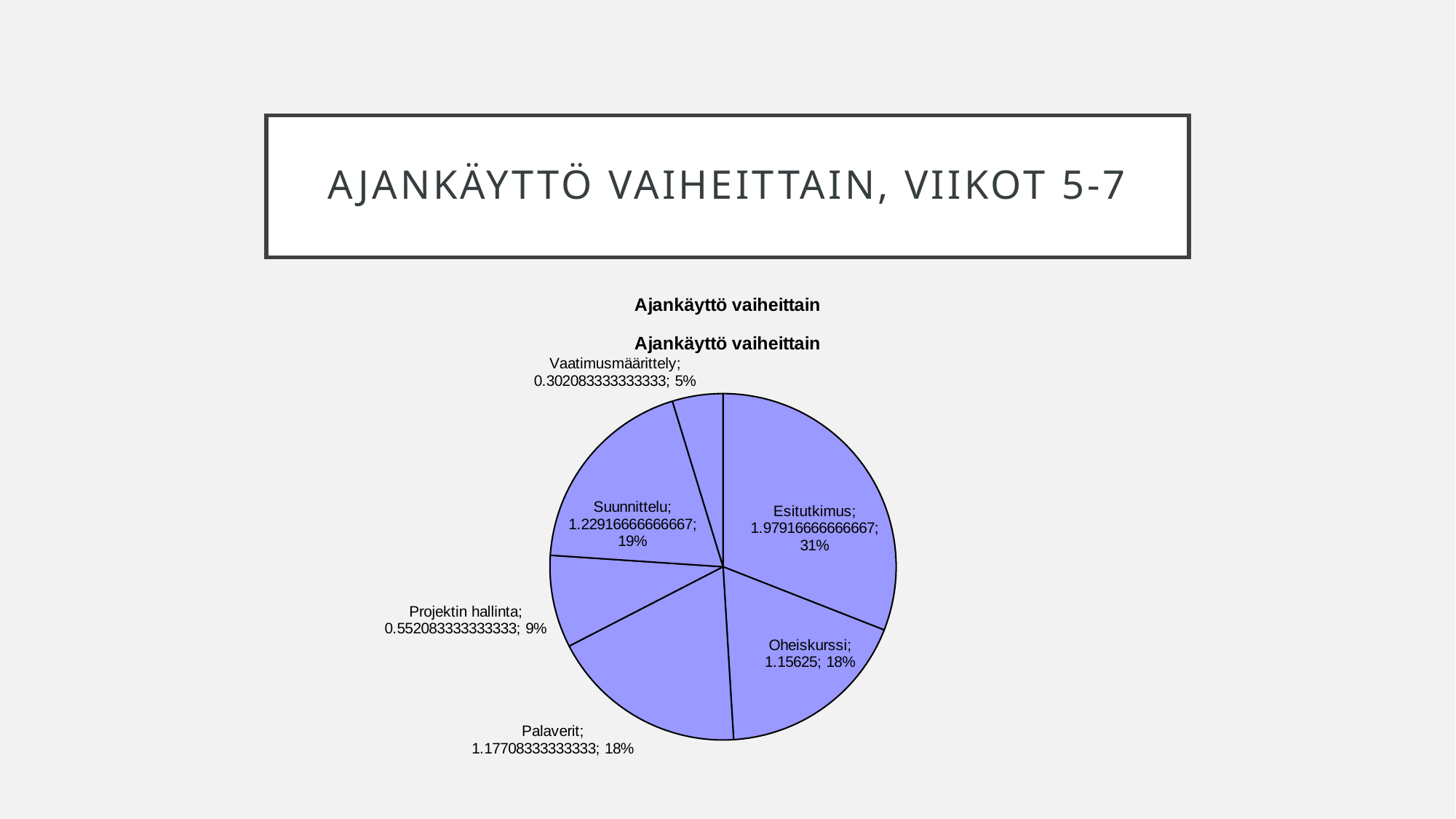
Which category has the smallest slice of the pie? Vaatimusmäärittely Which slice is larger, Suunnittelu or Projektin hallinta? Suunnittelu What is the title of the chart? Ajankäyttö vaiheittain What share of the pie does Projektin hallinta take? 9% How many slices does the pie chart have? 6 Which category has the largest slice of the pie? Esitutkimus What is the value shown for Suunnittelu? 1.22916666666667 What is the difference in percentage share between Esitutkimus and Suunnittelu? 12% What is the value shown for Oheiskurssi? 1.15625 What kind of chart is shown on the slide? pie chart What share of the pie does Esitutkimus take? 31% What is the difference between the values for Projektin hallinta and Vaatimusmäärittely? 0.25